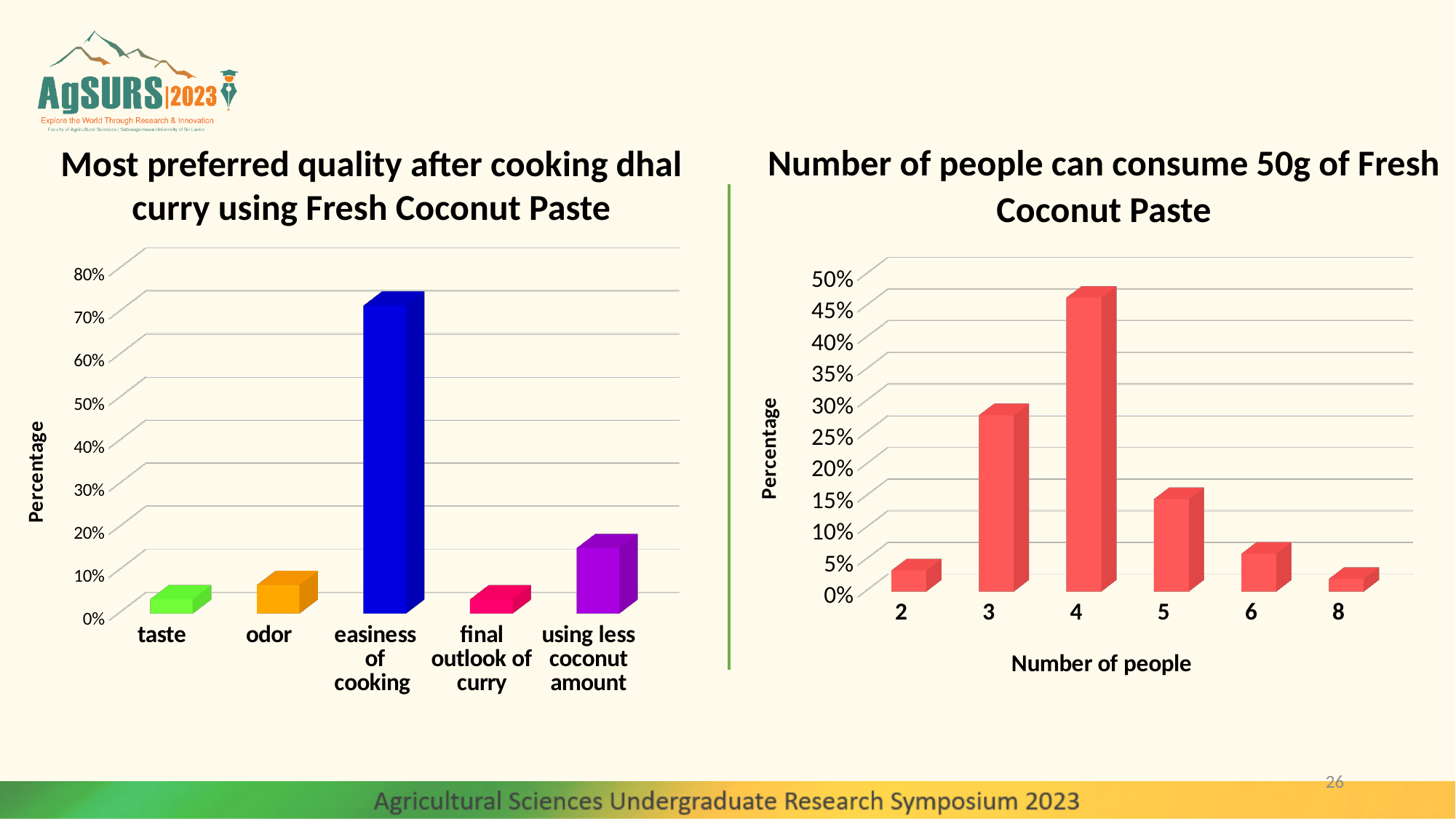
In the chart 'Most preferred quality after cooking dhal curry using Fresh Coconut Paste', is the value for using less coconut amount greater or less than 20%? less In the chart 'Most preferred quality after cooking dhal curry using Fresh Coconut Paste', which quality has the highest percentage? easiness of cooking In the chart 'Most preferred quality after cooking dhal curry using Fresh Coconut Paste', which is larger, the value for odor or the value for using less coconut amount? using less coconut amount In the chart 'Number of people can consume 50g of Fresh Coconut Paste', is the value for 3 people greater or less than 20%? greater In the chart 'Number of people can consume 50g of Fresh Coconut Paste', which is larger, the value for 5 people or the value for 6 people? 5 In the chart 'Number of people can consume 50g of Fresh Coconut Paste', is the value for 4 people greater or less than 40%? greater What kind of chart is 'Most preferred quality after cooking dhal curry using Fresh Coconut Paste'? bar chart What is the x-axis title of the chart 'Number of people can consume 50g of Fresh Coconut Paste'? Number of people In the chart 'Number of people can consume 50g of Fresh Coconut Paste', which number of people has the highest percentage? 4 How many categories are shown in the chart 'Most preferred quality after cooking dhal curry using Fresh Coconut Paste'? 5 How many categories are shown on the x axis of the chart 'Number of people can consume 50g of Fresh Coconut Paste'? 6